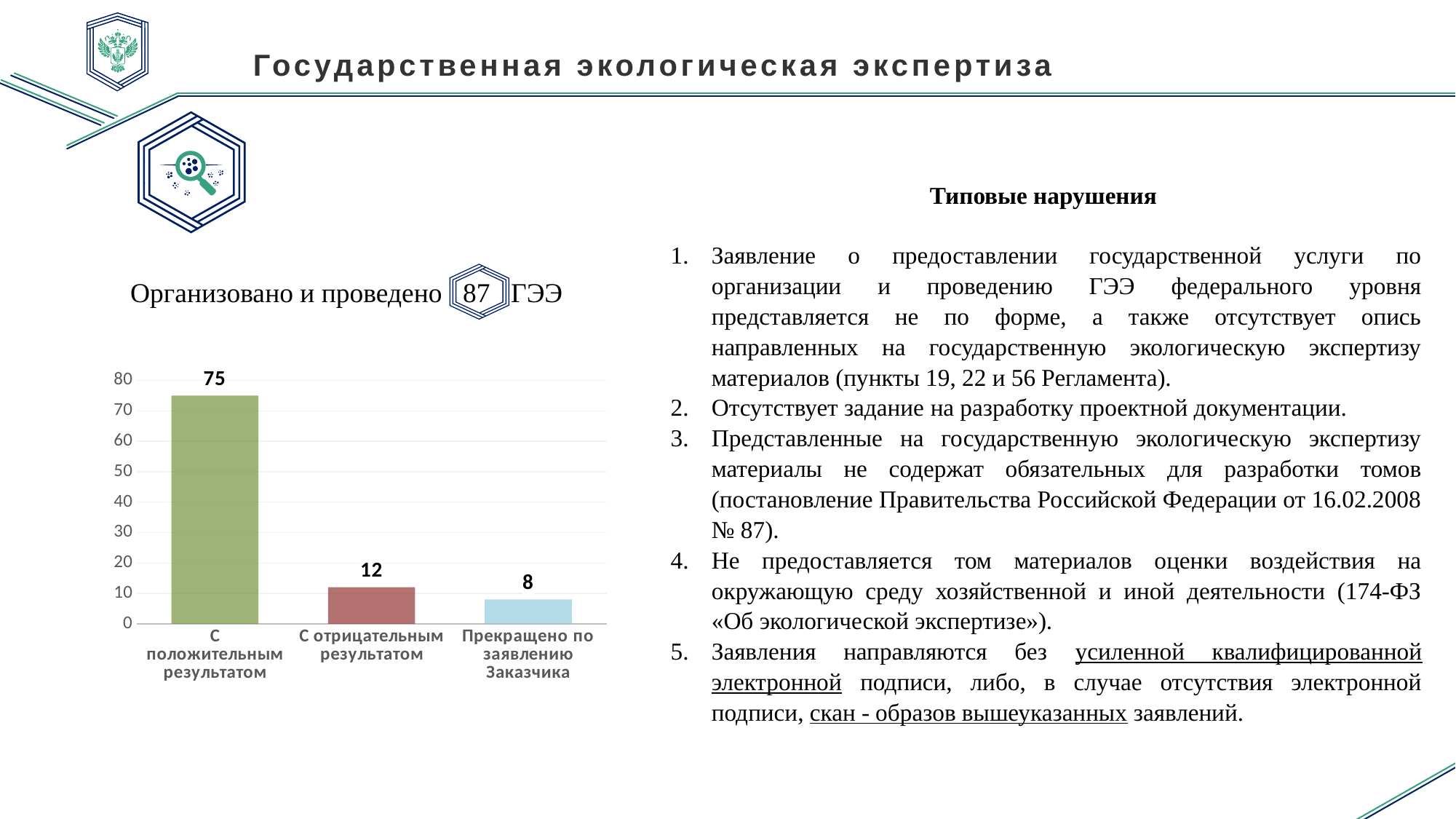
Which category has the highest value? С положительным результатом What is the highest value shown on the vertical axis of the chart? 80 Which category has the lowest value? Прекращено по заявлению Заказчика Which is larger: the value for "С отрицательным результатом" or for "Прекращено по заявлению Заказчика"? С отрицательным результатом What kind of chart is shown on the slide? bar chart What is the value for "Прекращено по заявлению Заказчика"? 8 What is the value for "С положительным результатом"? 75 What is the value for "С отрицательным результатом"? 12 How many categories are shown in the chart? 3 What is the difference between the values for "С отрицательным результатом" and "Прекращено по заявлению Заказчика"? 4 Is the value for "С положительным результатом" greater or less than 70? greater What is the difference between the values for "С положительным результатом" and "С отрицательным результатом"? 63